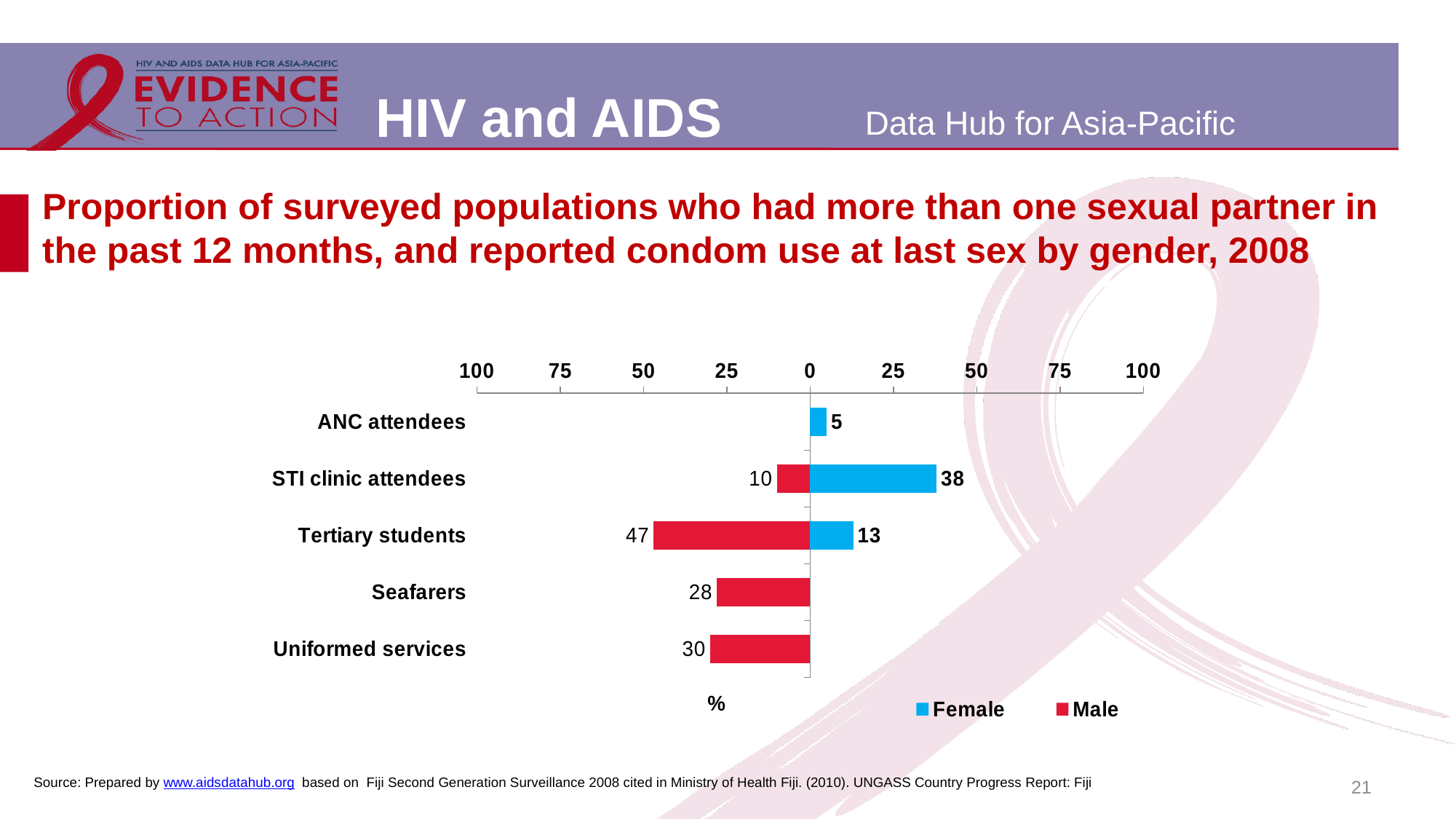
What kind of chart is shown on the slide? bar chart What is the Female value for ANC attendees? 5 Is the Male value for Seafarers greater or less than 25? greater What is the Female value for STI clinic attendees? 38 Which category has the lowest Female value among those with a Female bar? ANC attendees What is the Male value for Uniformed services? 30 How many series does the legend list? 2 Which is larger for STI clinic attendees, the Female value or the Male value? Female How many categories are shown on the chart? 5 What is the difference between the Male and Female values for Tertiary students? 34 Which category has the highest Male value? Tertiary students What is the Male value for Tertiary students? 47